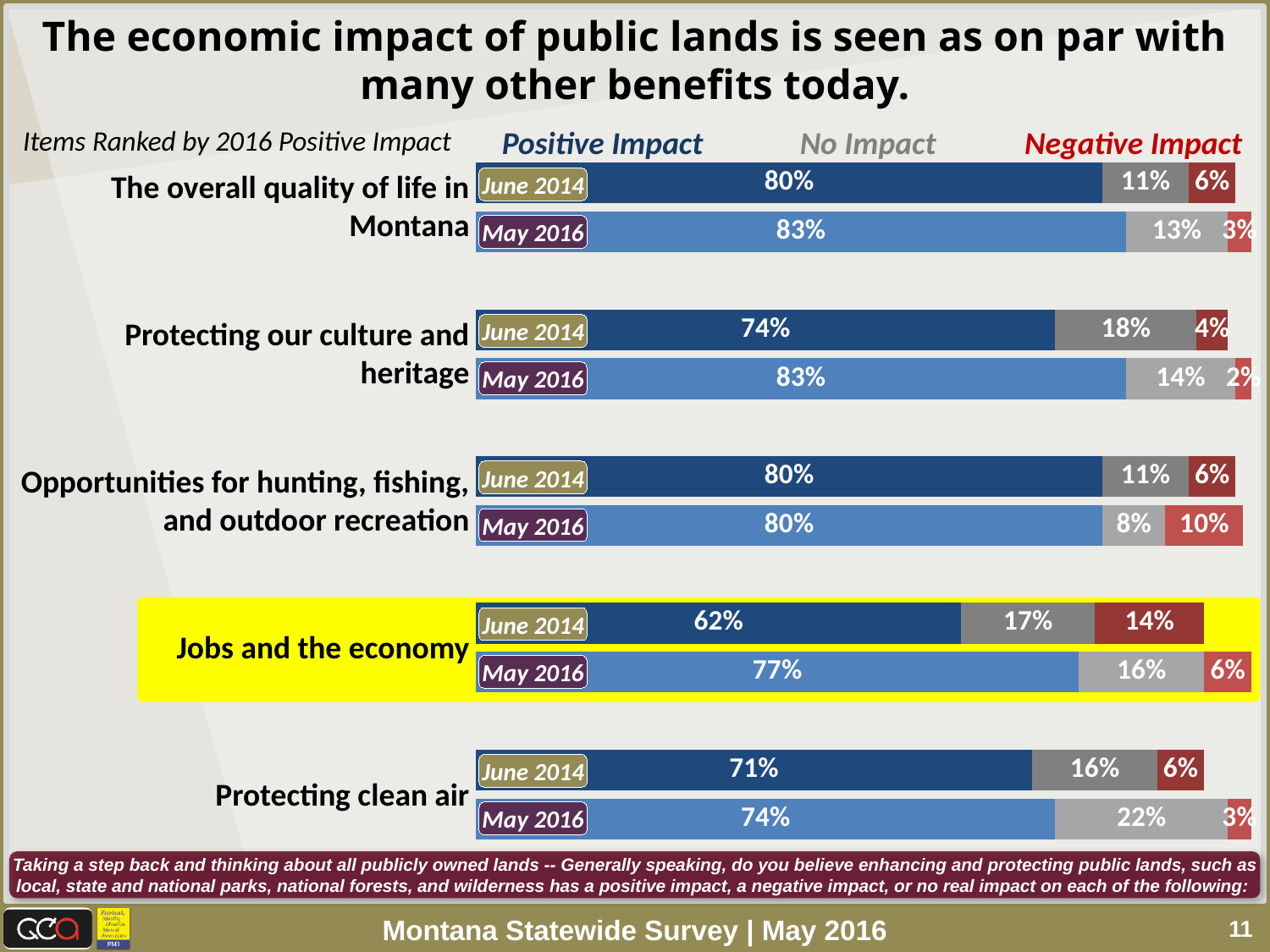
Which item is highlighted in yellow on the chart? Jobs and the economy What was the No Impact percentage for protecting clean air in May 2016? 22% How many items are ranked on the chart? 5 By how many percentage points did the Positive Impact for jobs and the economy change from June 2014 to May 2016? 15 percentage points What is the total of the three segments for jobs and the economy in June 2014? 93% How many impact categories does the chart legend list? 3 Which item had the lowest Positive Impact percentage in June 2014? Jobs and the economy Which is larger: the Positive Impact for protecting our culture and heritage in June 2014 or in May 2016? May 2016 Which item had the highest Negative Impact percentage in June 2014? Jobs and the economy What percentage said public lands have a positive impact on jobs and the economy in May 2016? 77% What kind of chart is shown on the slide? Stacked bar chart What was the Negative Impact percentage for opportunities for hunting, fishing, and outdoor recreation in May 2016? 10%